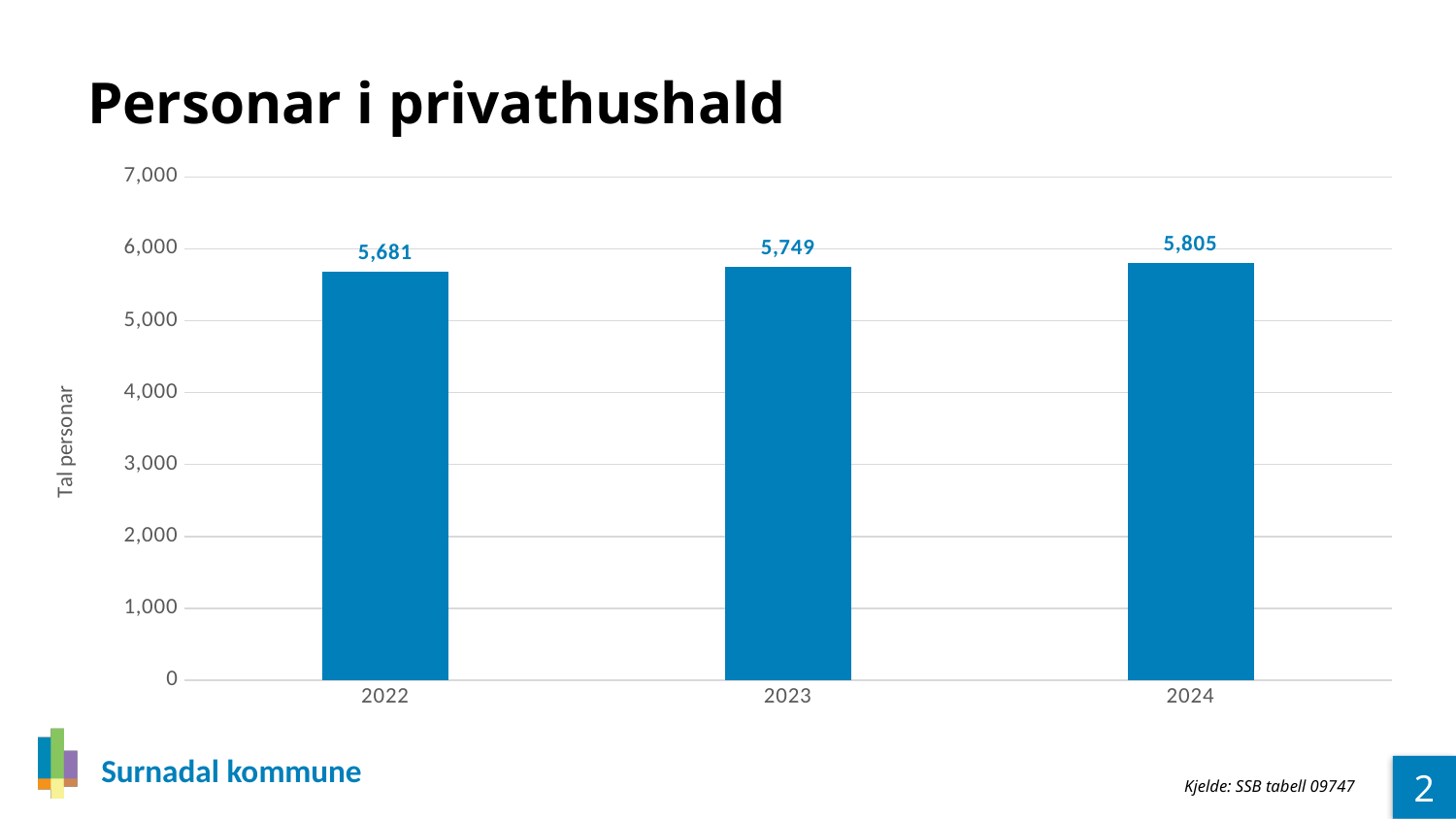
What is the difference between the values for 2024 and 2022? 124 Is the value for 2022 greater or less than 6,000? less What is the value for 2024? 5,805 Which is larger, the value for 2023 or the value for 2024? 2024 Which year has the highest value? 2024 How many years are shown on the x axis? 3 Which year has the lowest value? 2022 Do the values rise or fall from 2022 to 2024? rise What is the value for 2023? 5,749 What kind of chart is shown on the slide? bar chart What is the value for 2022? 5,681 What is the difference between the values for 2023 and 2022? 68